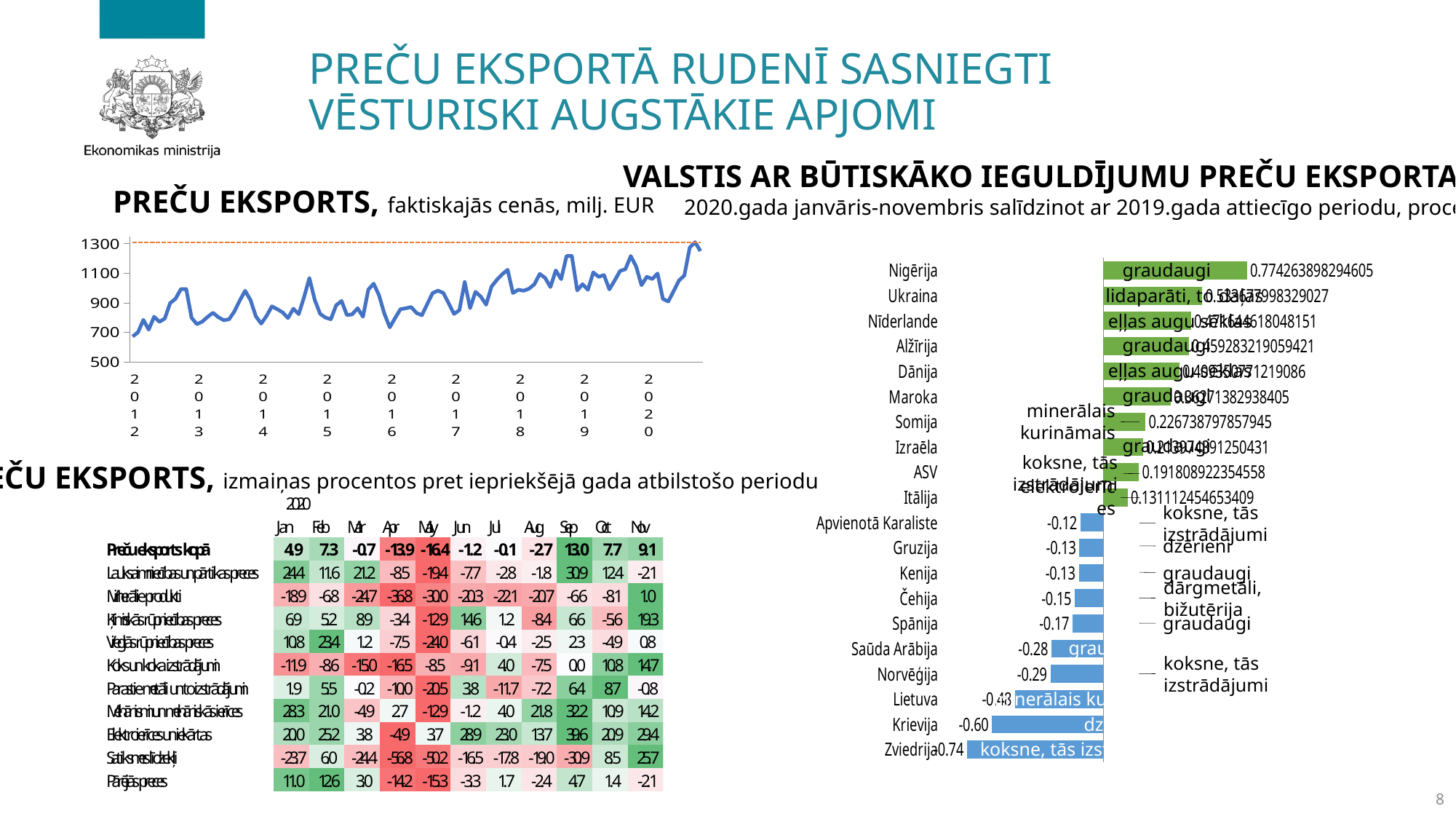
What kind of chart is the chart on the right listing countries such as Nigērija and Zviedrija? bar chart What kind of chart is the chart titled 'PREČU EKSPORTS, faktiskajās cenās, milj. EUR'? line chart In the bar chart on the right, what is the value shown for Nigērija? 0.774263898294605 In the line chart 'PREČU EKSPORTS, faktiskajās cenās, milj. EUR', do the values generally rise or fall from 2012 to 2020? rise How many countries are listed in the bar chart on the right? 20 In the bar chart on the right, which country has the lowest value? Zviedrija In the bar chart on the right, which has the larger value, Gruzija or Spānija? Gruzija In the bar chart on the right, which country has the highest value? Nigērija In the bar chart on the right, what is the value shown for ASV? 0.191808922354558 In the bar chart on the right, what is the difference between the values for Norvēģija and Krievija? 0.31 In the bar chart on the right, what is the value shown for Krievija? -0.60 In the bar chart on the right, what is the value shown for Somija? 0.226738797857945